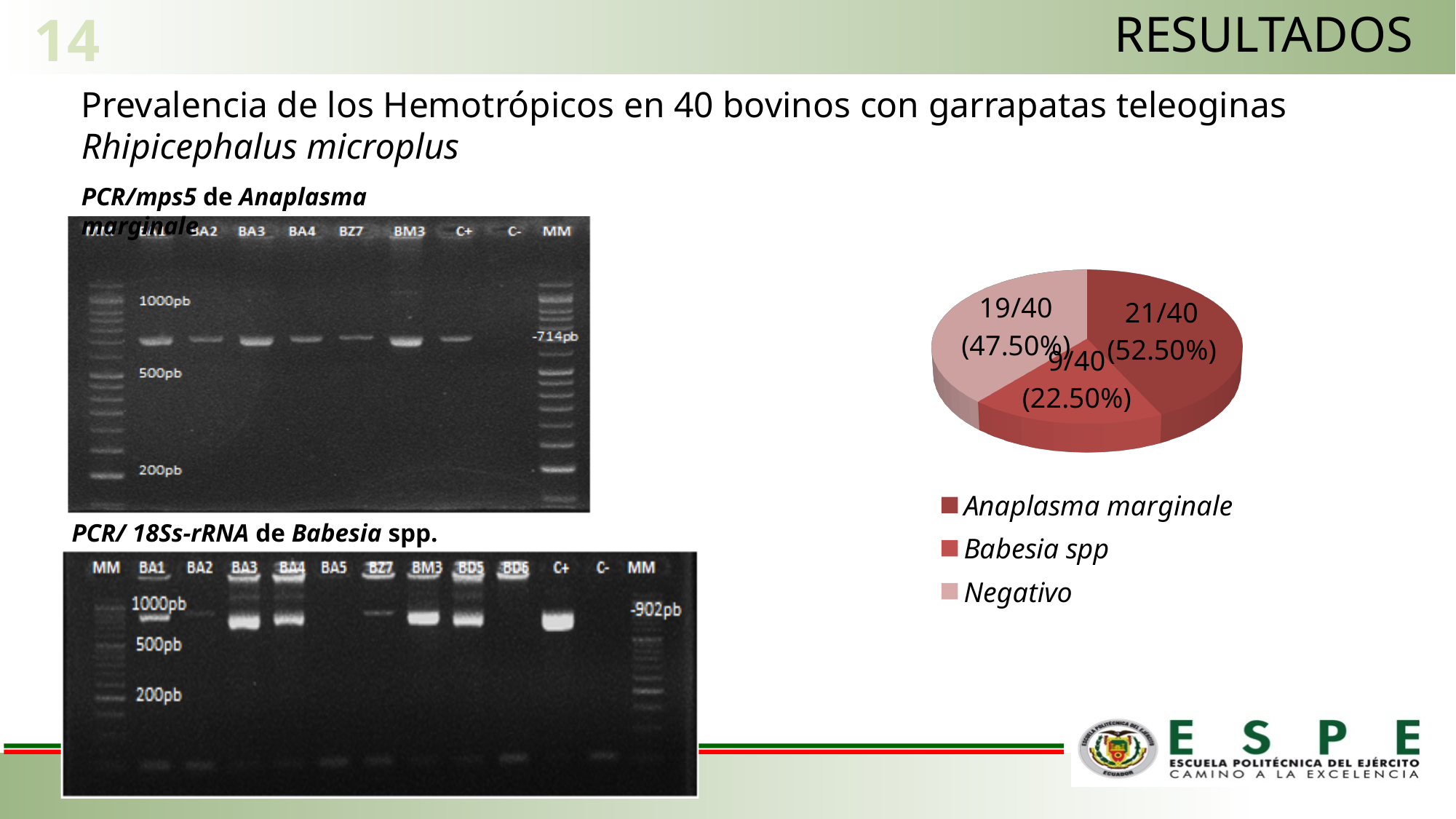
Which category in the pie chart has the smallest slice? Babesia spp In the pie chart, which is larger: the Negativo slice or the Babesia spp slice? Negativo How many slices does the pie chart have? 3 How many entries does the legend of the pie chart list? 3 What value is printed on the Negativo slice of the pie chart? 19/40 (47.50%) Which legend entry of the pie chart is shown in the lightest pink colour? Negativo What kind of chart is shown on the right side of the slide? pie chart How many more bovines are in the Anaplasma marginale slice than in the Babesia spp slice of the pie chart? 12 What percentage share of the pie chart is labelled for Negativo? 47.50% Which category in the pie chart has the largest slice? Anaplasma marginale What value is printed on the Babesia spp slice of the pie chart? 9/40 (22.50%) What value is printed on the Anaplasma marginale slice of the pie chart? 21/40 (52.50%)